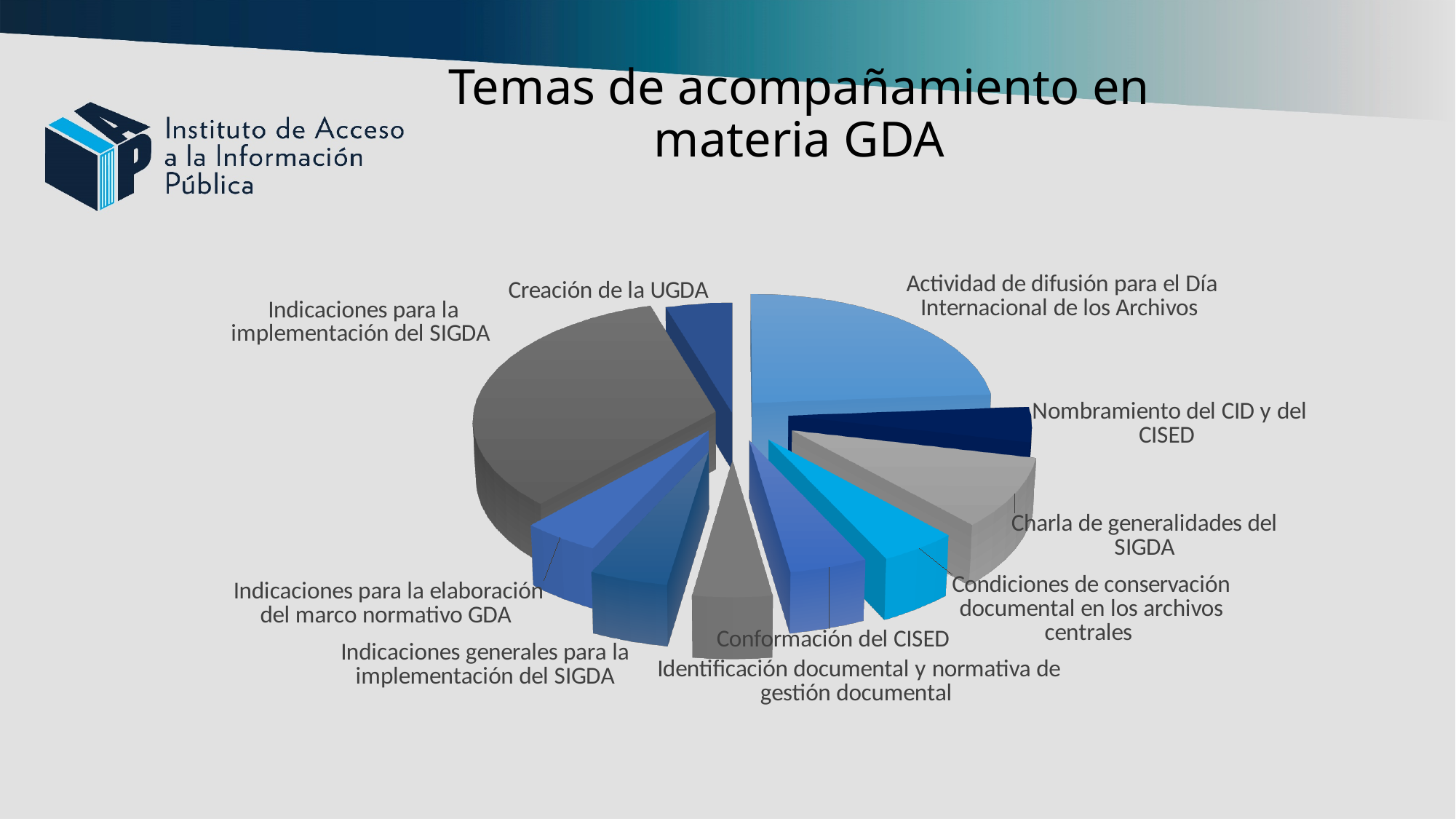
Which category is represented by the bright cyan slice in the pie chart? Condiciones de conservación documental en los archivos centrales Which slice is larger: "Actividad de difusión para el Día Internacional de los Archivos" or "Nombramiento del CID y del CISED"? Actividad de difusión para el Día Internacional de los Archivos Which slice is larger: "Indicaciones para la implementación del SIGDA" or "Conformación del CISED"? Indicaciones para la implementación del SIGDA Which category has the largest slice in the pie chart? Indicaciones para la implementación del SIGDA Which slice is larger: "Indicaciones para la implementación del SIGDA" or "Charla de generalidades del SIGDA"? Indicaciones para la implementación del SIGDA What kind of chart is shown on the slide? pie chart How many categories (slices) does the pie chart have? 10 What is the title of the slide containing the pie chart? Temas de acompañamiento en materia GDA